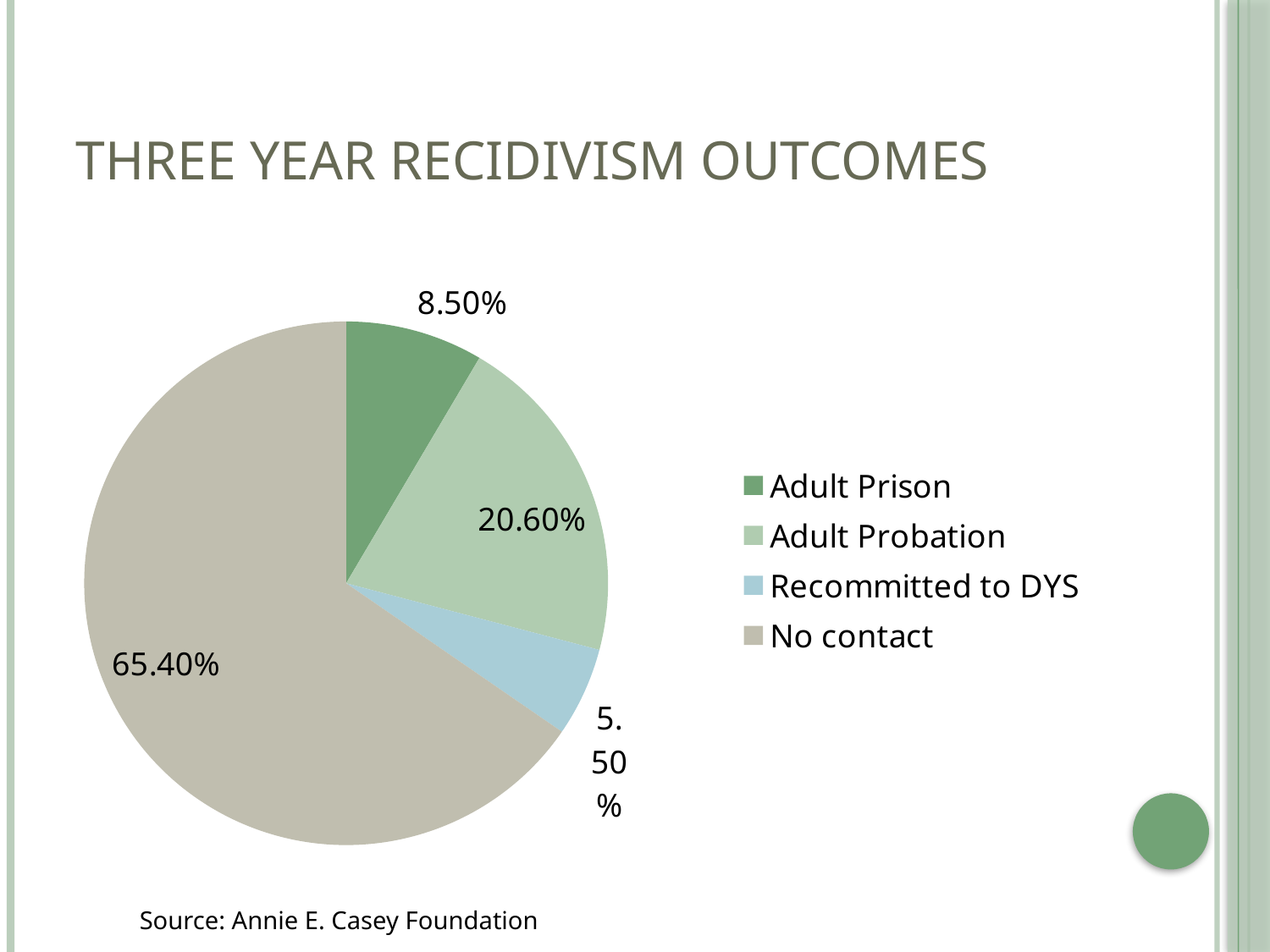
What percentage of the pie is Adult Prison? 8.50% Which category has the largest share of the pie? No contact What percentage of the pie is Adult Probation? 20.60% What percentage of the pie is No contact? 65.40% What kind of chart is shown on the slide? pie chart Which is larger, the Adult Prison share or the Recommitted to DYS share? Adult Prison How many categories does the pie chart have? 4 What is the difference between the Adult Probation and Adult Prison shares? 12.10% What percentage of the pie is Recommitted to DYS? 5.50% What source is cited below the chart? Annie E. Casey Foundation What is the title of the chart on the slide? Three Year Recidivism Outcomes Which category has the smallest share of the pie? Recommitted to DYS